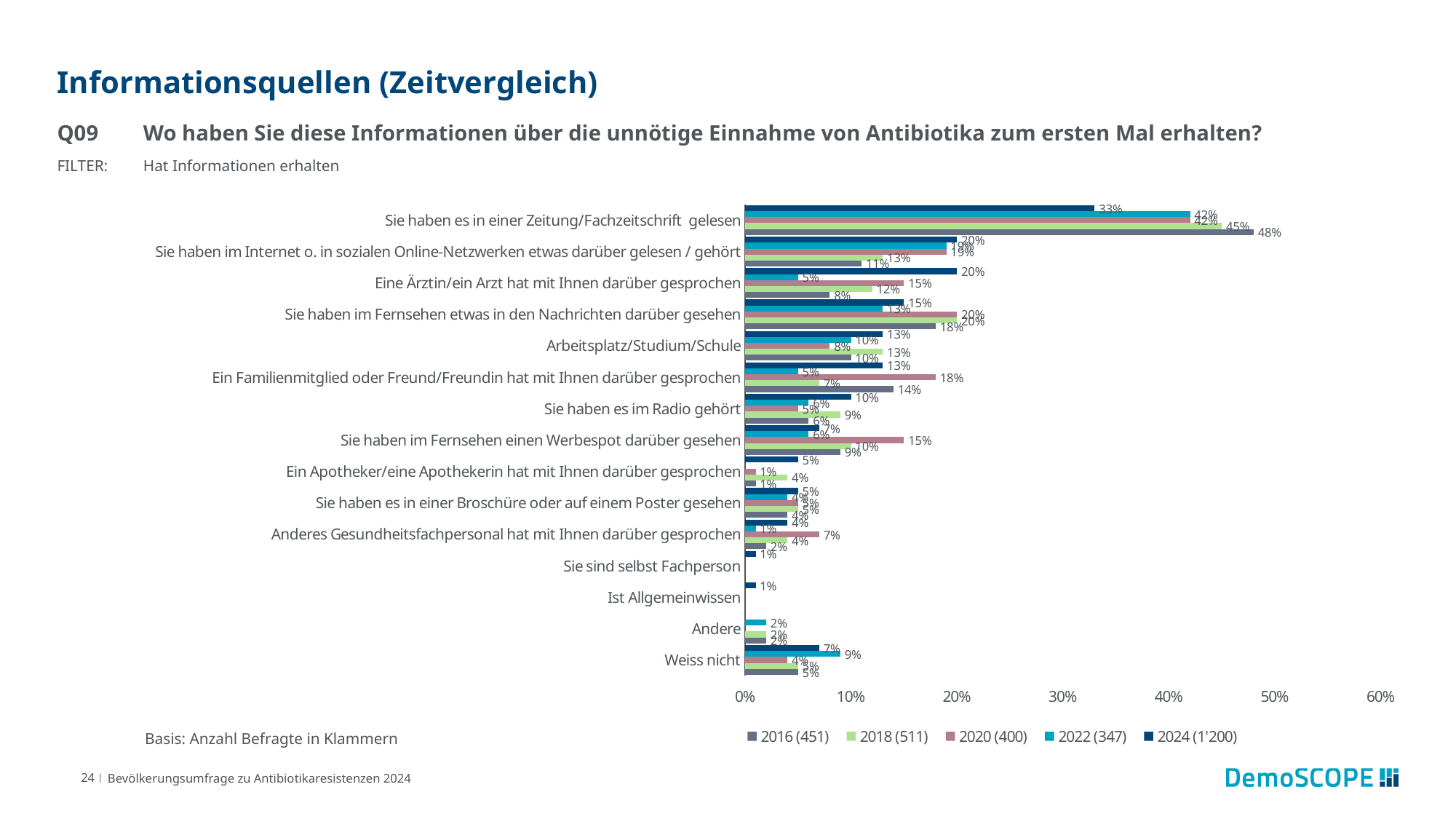
How many information-source categories are listed on the y axis of the chart? 15 How many series (survey years) does the legend list? 5 What is the 2022 value for 'Weiss nicht'? 9% For 'Ein Familienmitglied oder Freund/Freundin hat mit Ihnen darüber gesprochen', which is larger: the 2020 value or the 2024 value? 2020 According to the legend, how many respondents were surveyed in 2024? 1'200 Which category has the highest 2024 value? Sie haben es in einer Zeitung/Fachzeitschrift gelesen What kind of chart is shown on the slide? Bar chart What is the 2020 value for 'Sie haben im Fernsehen einen Werbespot darüber gesehen'? 15% By how many percentage points did the value for 'Sie haben es in einer Zeitung/Fachzeitschrift gelesen' fall from 2016 to 2024? 15 percentage points What is the 2024 value for 'Sie haben es in einer Zeitung/Fachzeitschrift gelesen'? 33% What is the 2024 value for 'Eine Ärztin/ein Arzt hat mit Ihnen darüber gesprochen'? 20% What is the 2016 value for 'Sie haben es in einer Zeitung/Fachzeitschrift gelesen'? 48%